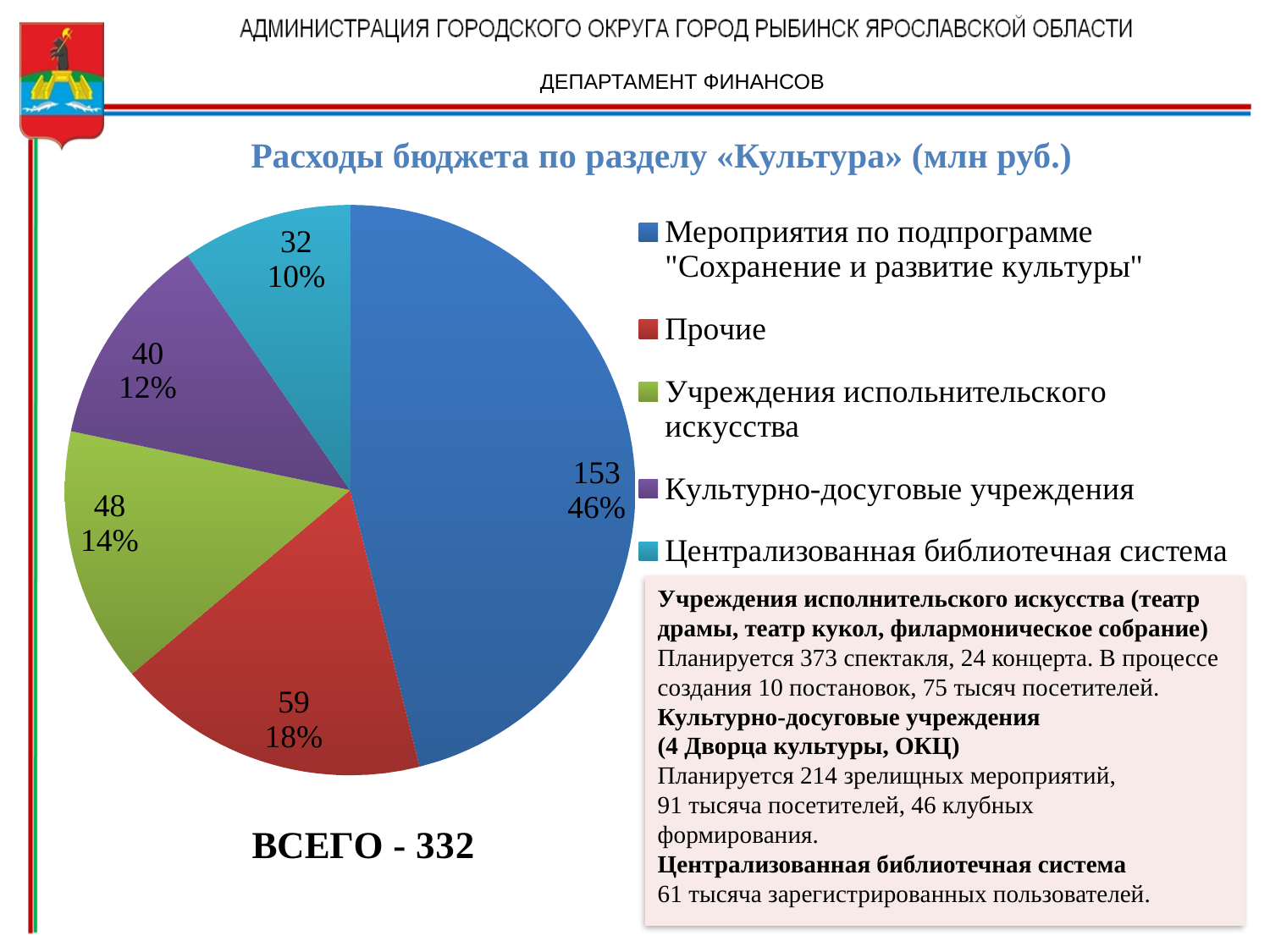
What is the value for «Прочие»? 59 What share of the pie does «Учреждения испольнительского искусства» take? 14% What kind of chart is shown on the slide? pie chart What is the value for «Централизованная библиотечная система»? 32 Which category has the largest slice? Мероприятия по подпрограмме "Сохранение и развитие культуры" What is the value for «Мероприятия по подпрограмме "Сохранение и развитие культуры"»? 153 Which is larger: «Культурно-досуговые учреждения» or «Централизованная библиотечная система»? Культурно-досуговые учреждения What share of the pie does «Культурно-досуговые учреждения» take? 12% Which category has the smallest slice? Централизованная библиотечная система What is the difference between the values for «Прочие» and «Учреждения испольнительского искусства»? 11 What is the title of the chart? Расходы бюджета по разделу «Культура» (млн руб.) How many slices does the pie chart have? 5